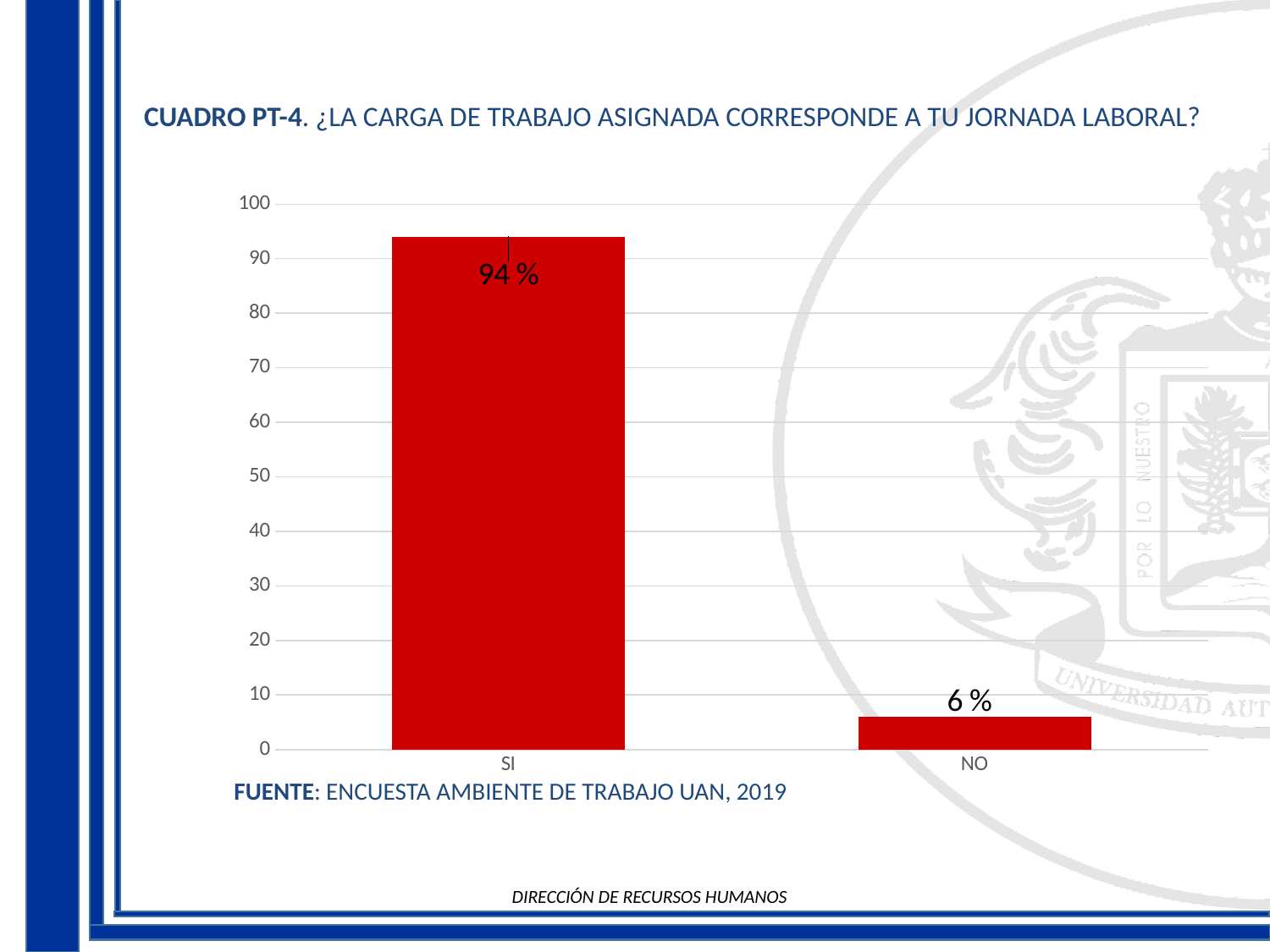
How many categories are shown on the x axis? 2 Is the value for SI greater or less than 90? greater Which is larger, the value for SI or the value for NO? SI What kind of chart is shown on the slide? bar chart Which category has the lowest value? NO Which category has the highest value? SI What is the value for NO? 6 % What source is cited below the chart? ENCUESTA AMBIENTE DE TRABAJO UAN, 2019 Is the value for NO greater or less than 10? less What is the difference between the values for SI and NO? 88 % What is the title of the chart? CUADRO PT-4. ¿LA CARGA DE TRABAJO ASIGNADA CORRESPONDE A TU JORNADA LABORAL? What is the value for SI? 94 %